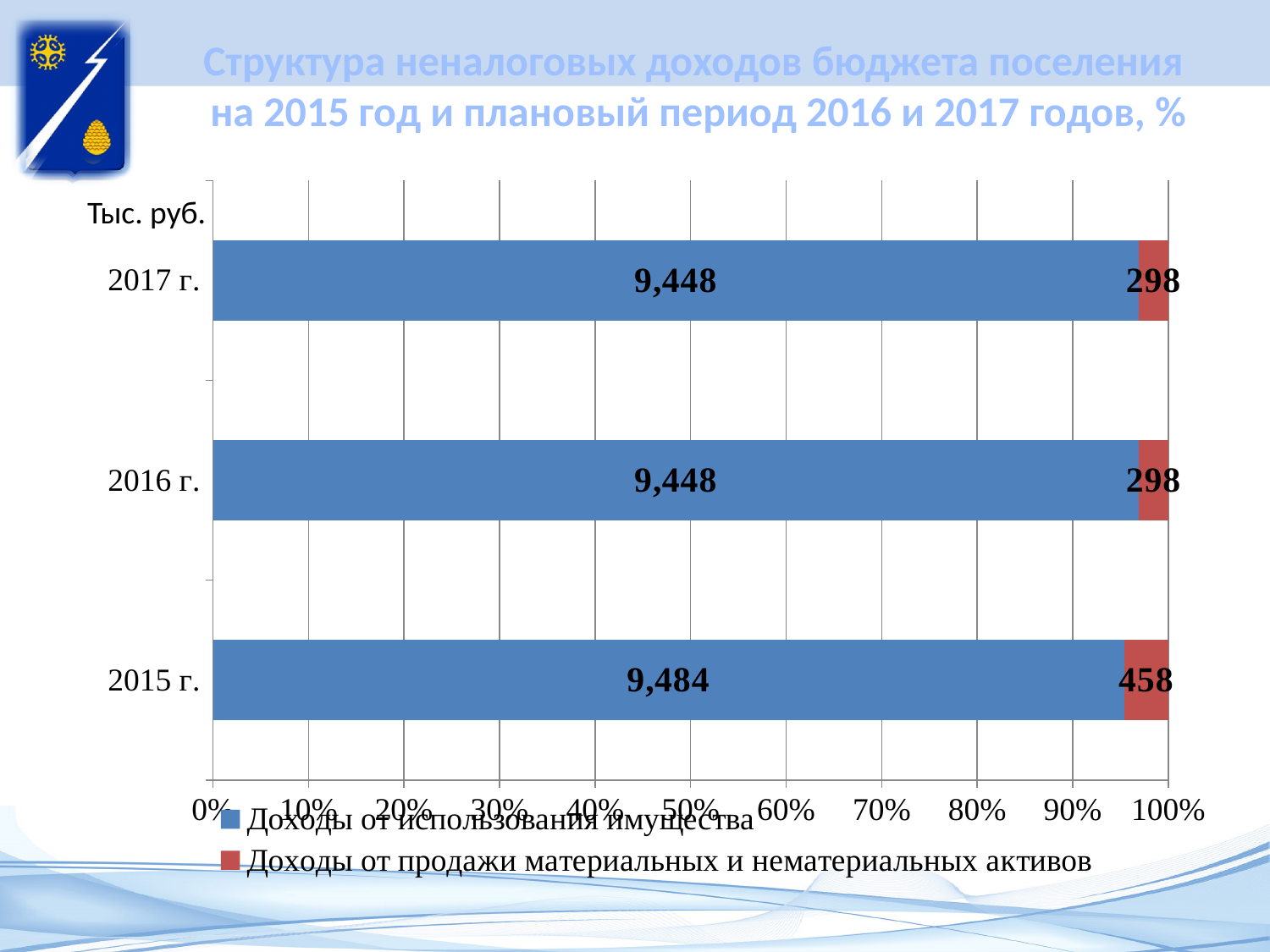
What is the total of the two values shown for 2015 г.? 9,942 What is the value for Доходы от использования имущества in 2015 г.? 9,484 What is the value for Доходы от продажи материальных и нематериальных активов in 2015 г.? 458 What is the difference between the Доходы от использования имущества values for 2015 г. and 2017 г.? 36 What is the value for Доходы от использования имущества in 2016 г.? 9,448 How many series does the legend list? 2 In which year is the value for Доходы от продажи материальных и нематериальных активов highest? 2015 г. What is the value for Доходы от продажи материальных и нематериальных активов in 2017 г.? 298 What is the difference between the Доходы от продажи материальных и нематериальных активов values for 2015 г. and 2016 г.? 160 Which is larger in 2015 г.: Доходы от использования имущества or Доходы от продажи материальных и нематериальных активов? Доходы от использования имущества How many years are shown on the chart? 3 What kind of chart is shown on the slide? Stacked bar chart